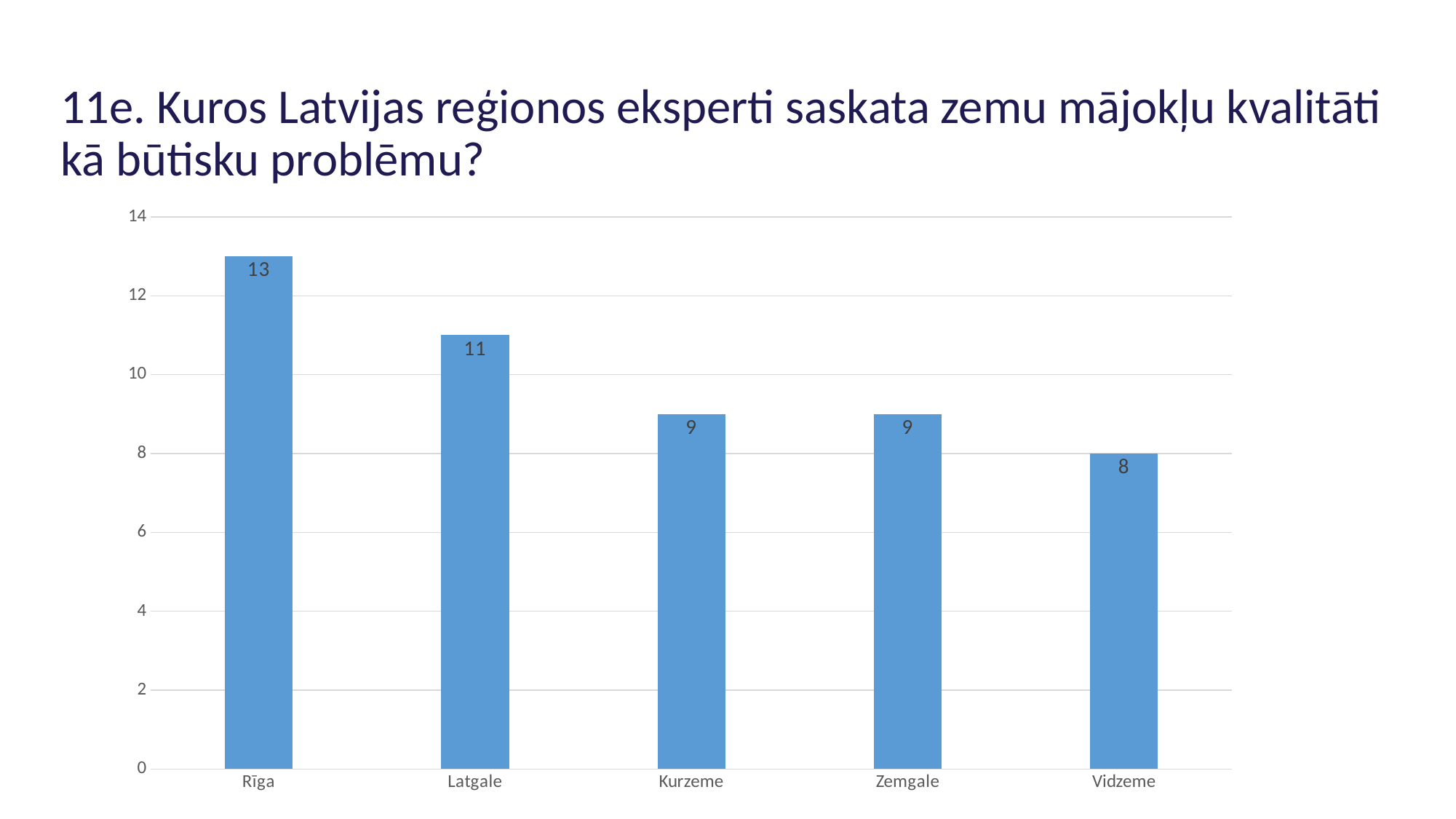
Which region has the lowest value? Vidzeme What is the value for Vidzeme? 8 Do the values rise or fall from Rīga to Vidzeme along the x axis? Fall Which region has the highest value? Rīga How many regions are shown on the chart? 5 What is the difference between the values for Latgale and Vidzeme? 3 What kind of chart is shown on the slide? Bar chart What is the value for Kurzeme? 9 What is the value for Latgale? 11 Which is larger, the value for Latgale or the value for Zemgale? Latgale What is the difference between the values for Rīga and Latgale? 2 What is the value for Rīga? 13